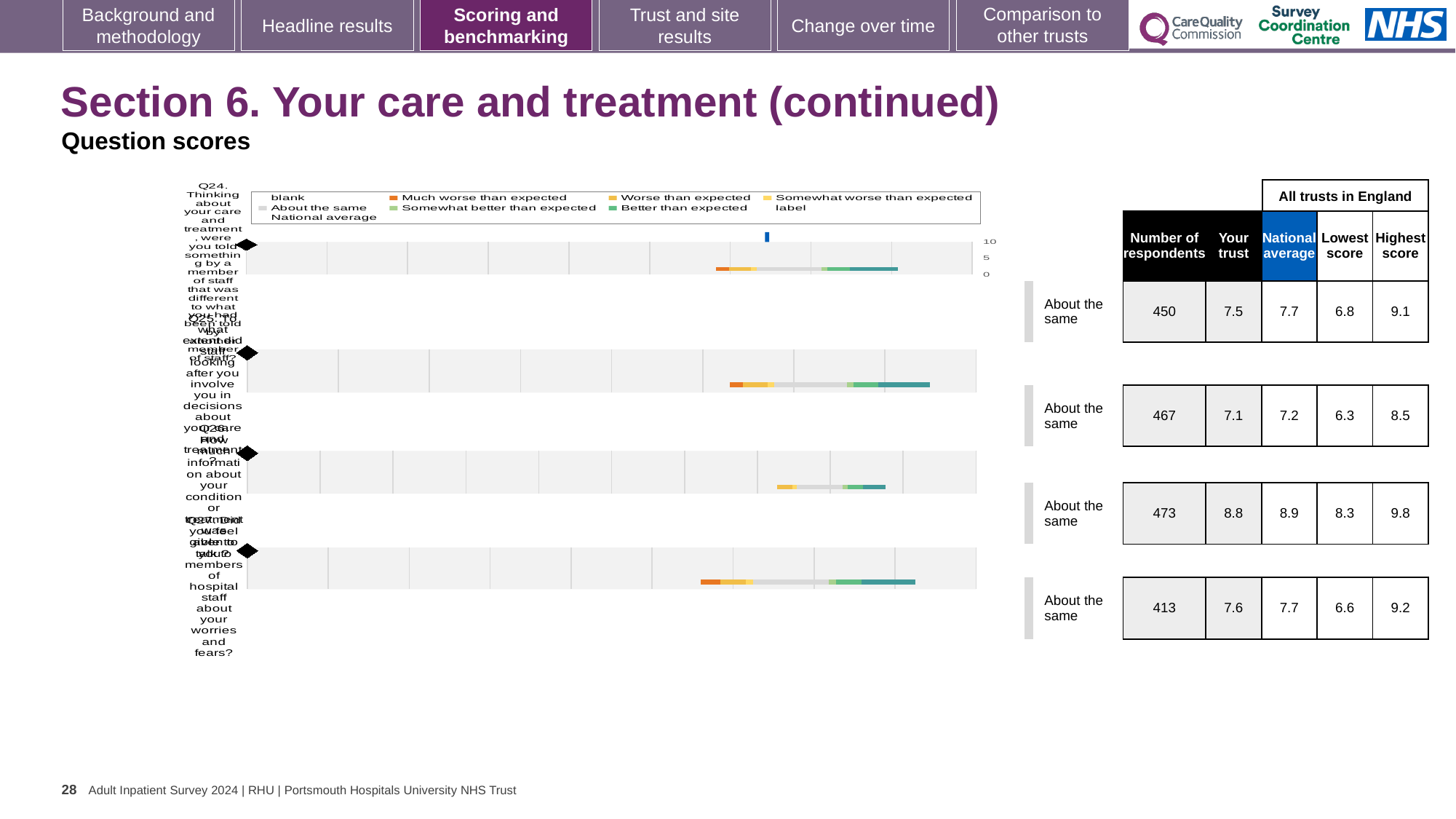
How many question charts are shown on the slide? 4 In the table next to the top chart (Q24), what is the number of respondents? 450 For the top chart (Q24), what is the difference between the highest score and the lowest score? 2.3 Which of the four questions (Q24–Q27) has the highest 'Your trust' score? Q26 In the legend, what colour represents 'Much worse than expected'? orange What benchmark category label is shown beside each of the four charts? About the same For the second chart (Q25), what is the 'Your trust' score shown in the table? 7.1 Which of the four questions (Q24–Q27) has the lowest number of respondents? Q27 For the third chart (Q26), what is the national average score shown in the table? 8.9 For the top chart (Q24), is the 'Your trust' score higher or lower than the national average? lower For the bottom chart (Q27), what is the highest score among all trusts in England? 9.2 What kind of chart is used for each question on the slide? bar chart